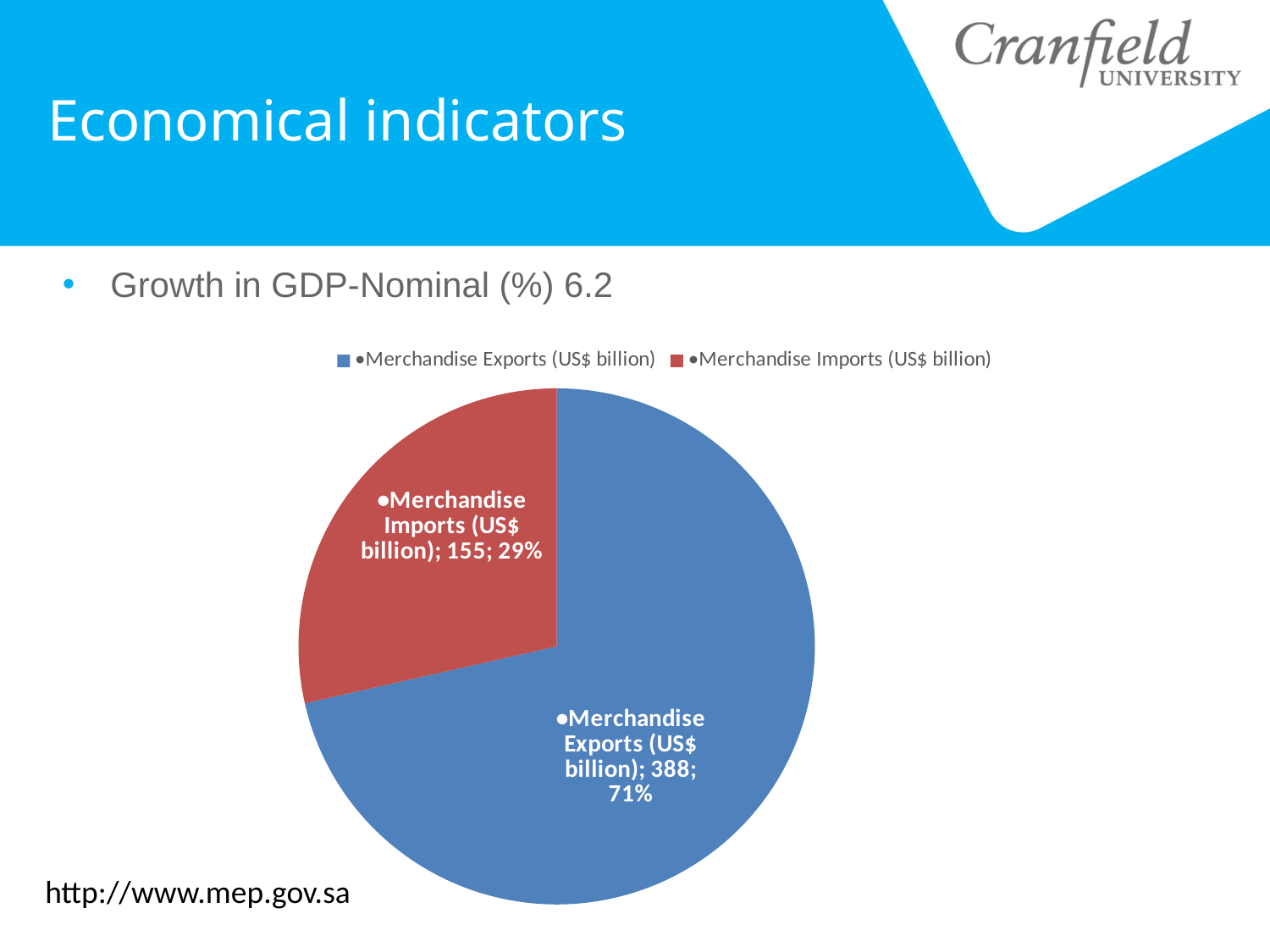
How many slices does the pie chart have? 2 What is the difference between the Merchandise Exports and Merchandise Imports values? 233 How many entries does the legend list? 2 Which slice is the smallest? Merchandise Imports (US$ billion) What is the value for Merchandise Imports (US$ billion)? 155 What is the value for Merchandise Exports (US$ billion)? 388 Which is larger, Merchandise Exports or Merchandise Imports? Merchandise Exports What share of the pie does Merchandise Exports (US$ billion) represent? 71% What type of chart is shown on the slide? pie chart Which slice is the largest? Merchandise Exports (US$ billion) What share of the pie does Merchandise Imports (US$ billion) represent? 29% What colour is the Merchandise Imports slice? red